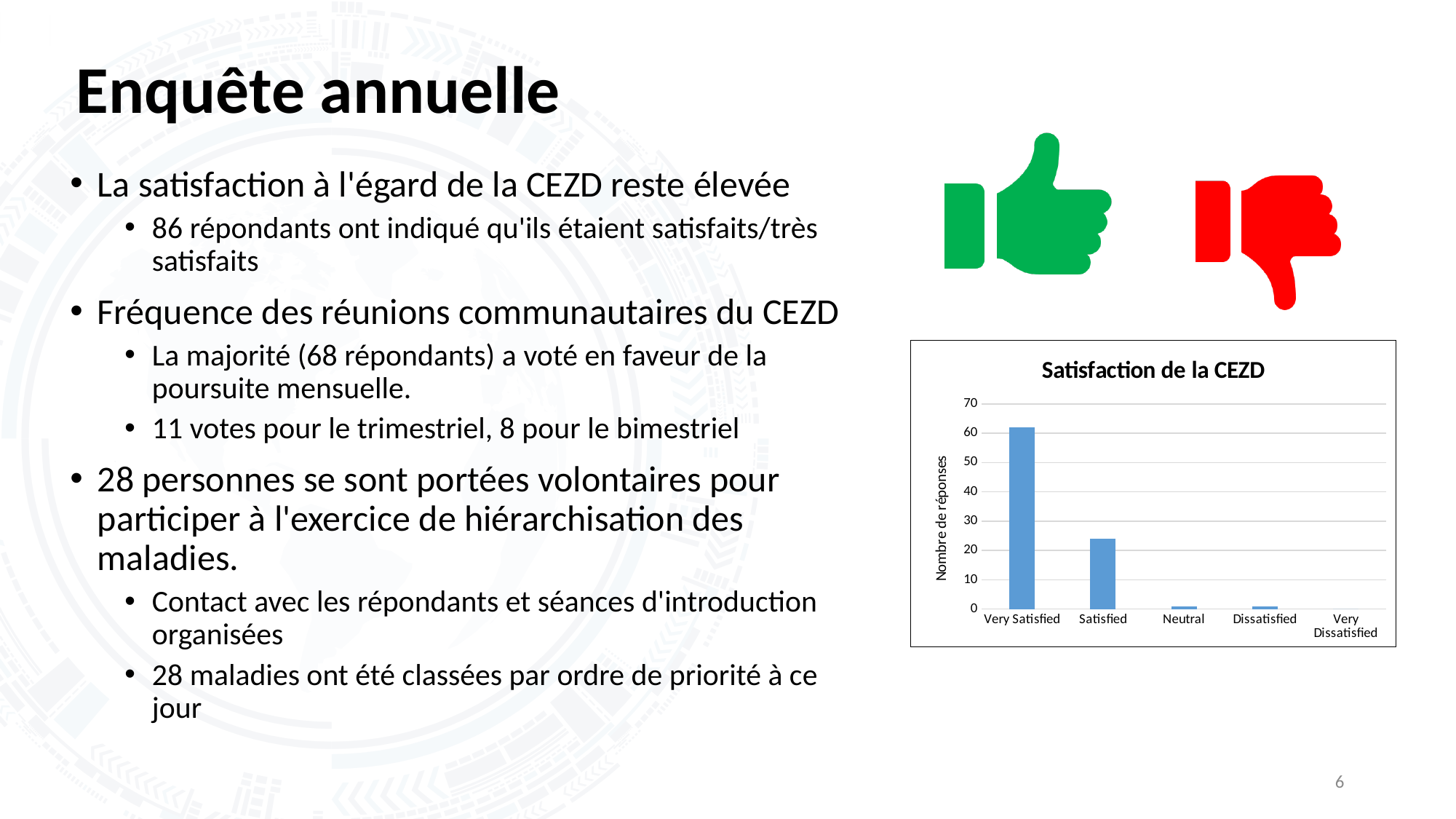
Which has more responses, Very Satisfied or Satisfied? Very Satisfied Is the value for Neutral greater or less than 10? less What kind of chart is shown on the slide? bar chart How many categories are shown on the x axis of the chart? 5 Is the value for Very Satisfied greater or less than 50? greater Which category has the highest number of responses? Very Satisfied Do the values rise or fall moving from Very Satisfied to Very Dissatisfied along the x axis? fall Which category has the lowest number of responses? Very Dissatisfied Is the value for Satisfied greater or less than 20? greater What is the title of the chart? Satisfaction de la CEZD What is the label on the vertical axis of the chart? Nombre de réponses